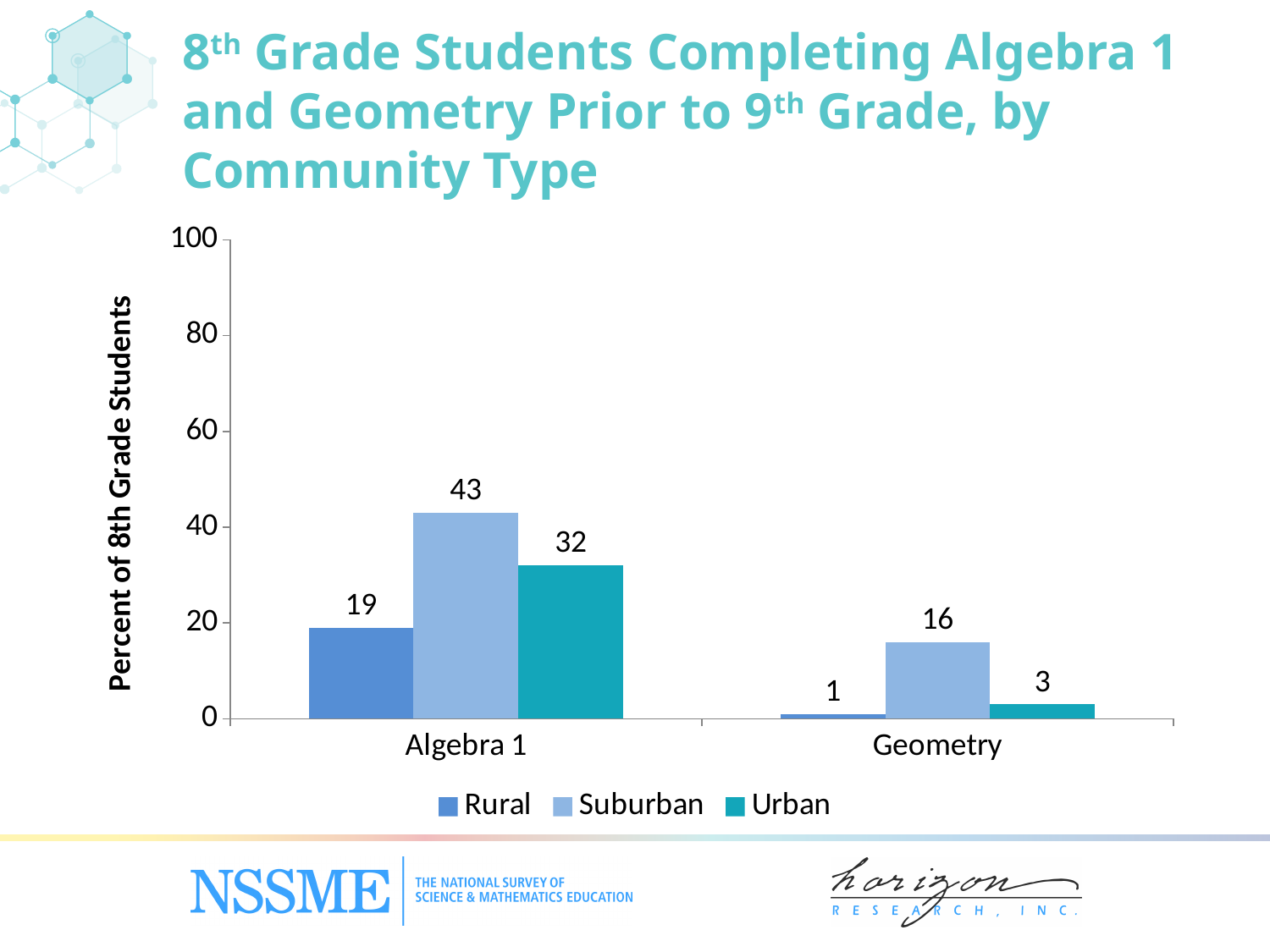
Which is larger, the Urban value for Algebra 1 or the Rural value for Algebra 1? Urban What is the label of the vertical axis? Percent of 8th Grade Students What is the value for Rural students in the Algebra 1 category? 19 How many series does the legend list? 3 What is the difference between the Suburban and Urban values for Algebra 1? 11 Is the Suburban value for Algebra 1 greater or less than 40? greater What percent of 8th grade students in suburban communities completed Algebra 1 prior to 9th grade? 43 Which community type has the highest value for Algebra 1? Suburban Which community type has the lowest value for Geometry? Rural What is the difference between the Suburban values for Algebra 1 and Geometry? 27 What is the value for Urban students in the Geometry category? 3 What kind of chart is shown on the slide? Bar chart